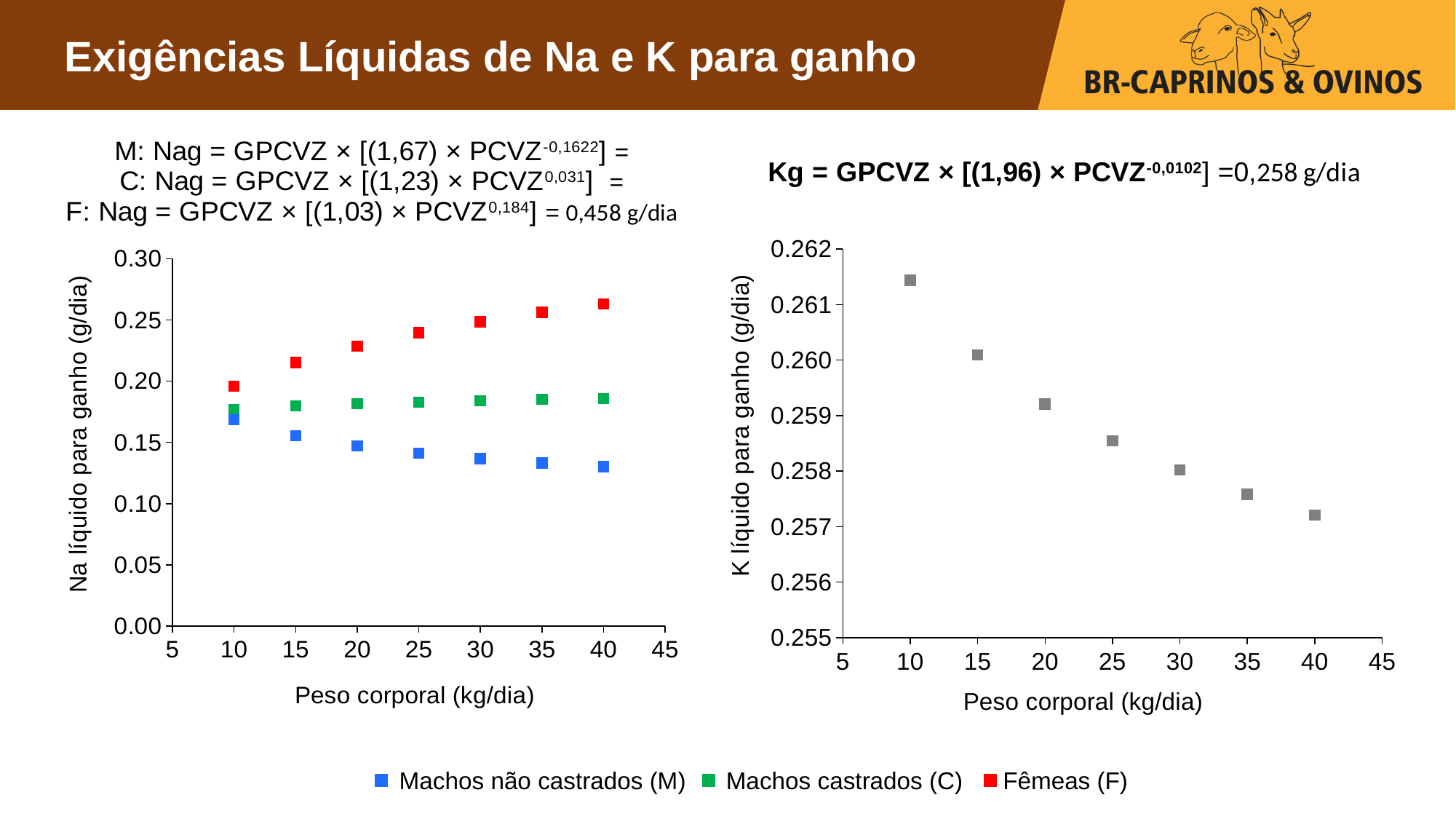
What is the x-axis title of the right chart (K líquido para ganho)? Peso corporal (kg/dia) In the right chart (K líquido para ganho), is the value at 40 kg greater or less than 0.258? less In the left chart (Na líquido para ganho), is the value for Machos castrados (C) at 40 kg greater or less than 0.20? less What kind of chart is the left chart (Na líquido para ganho)? scatter chart In the left chart (Na líquido para ganho), which is larger at 30 kg: Machos castrados (C) or Machos não castrados (M)? Machos castrados (C) In the left chart (Na líquido para ganho), do the values for Fêmeas (F) rise or fall as body weight increases? rise In the left chart (Na líquido para ganho), is the value for Fêmeas (F) at 40 kg greater or less than 0.25? greater In the left chart (Na líquido para ganho), how many points are plotted for the Fêmeas (F) series? 7 How many series does the legend list for the left chart (Na líquido para ganho)? 3 In the left chart (Na líquido para ganho), do the values for Machos não castrados (M) rise or fall as body weight increases? fall In the left chart (Na líquido para ganho), which series has the highest value at 40 kg? Fêmeas (F) In the right chart (K líquido para ganho), do the values rise or fall as body weight increases? fall